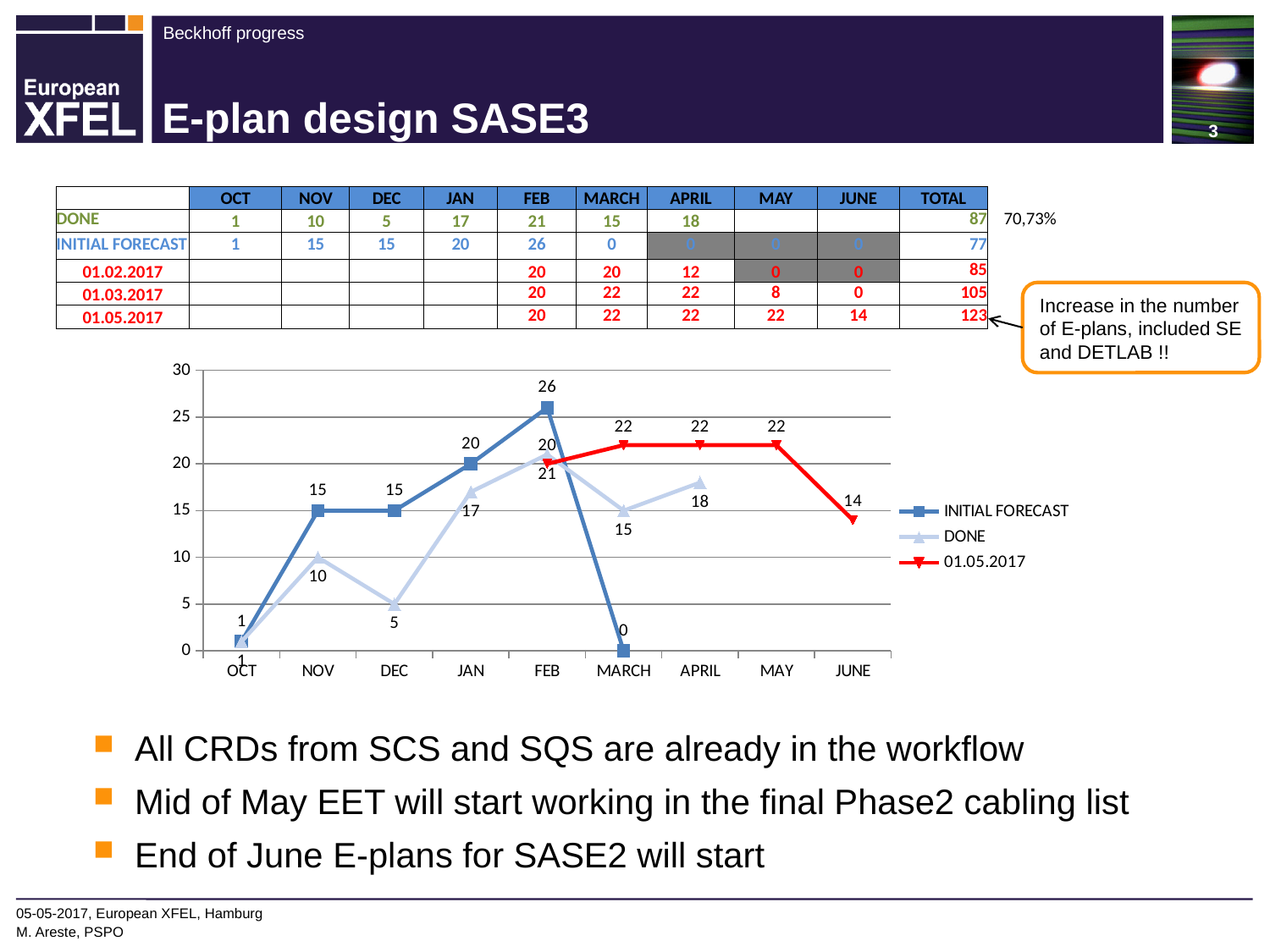
What is the difference between the INITIAL FORECAST and DONE values for NOV? 5 In which month does the INITIAL FORECAST series reach its highest value? FEB For JAN, which is larger: the INITIAL FORECAST value or the DONE value? INITIAL FORECAST Does the 01.05.2017 series rise or fall from MAY to JUNE? fall What colour is the 01.05.2017 line in the chart? red In which month is the DONE series at its lowest value? OCT What kind of chart is shown on the slide? line chart How many months are shown along the x axis of the chart? 9 What is the 01.05.2017 value for JUNE in the chart? 14 What is the DONE value for NOV in the chart? 10 What is the INITIAL FORECAST value for FEB in the chart? 26 How many series does the chart's legend list? 3